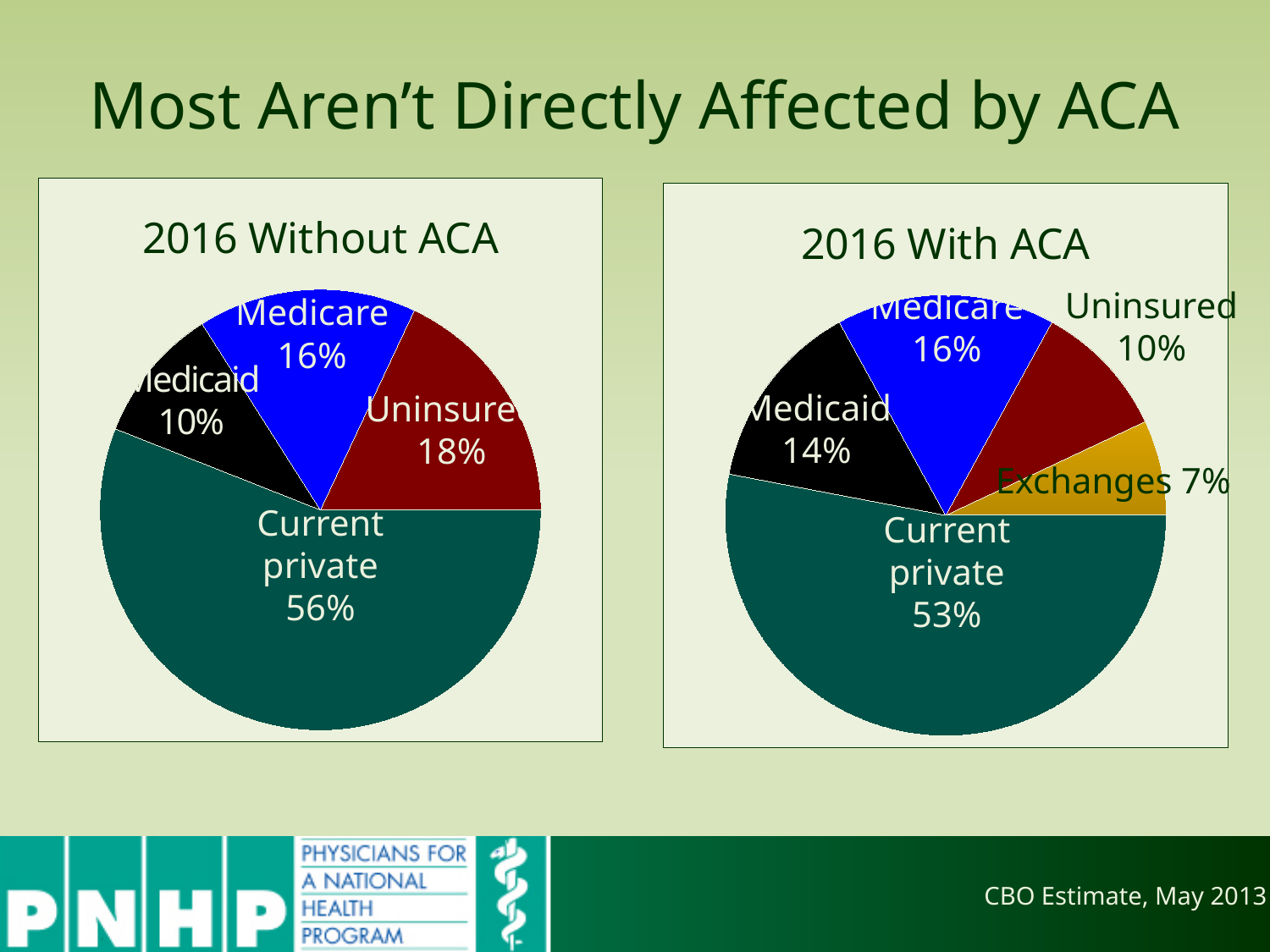
In the "2016 Without ACA" chart, which category has the smallest share? Medicaid In the "2016 With ACA" chart, which is larger: Medicaid or Uninsured? Medicaid What is the title of the chart on the right side of the slide? 2016 With ACA In the "2016 Without ACA" chart, what share is Uninsured? 18% In the "2016 With ACA" chart, what share is Exchanges? 7% In the "2016 With ACA" chart, which category has the smallest share? Exchanges What is the difference between the Uninsured share in the "2016 Without ACA" chart and the Uninsured share in the "2016 With ACA" chart? 8% In the "2016 Without ACA" chart, which category has the largest share? Current private What type of chart is the "2016 Without ACA" chart? Pie chart How many slices does the "2016 Without ACA" chart have? 4 How many slices does the "2016 With ACA" chart have? 5 In the "2016 With ACA" chart, what share is Medicaid? 14%